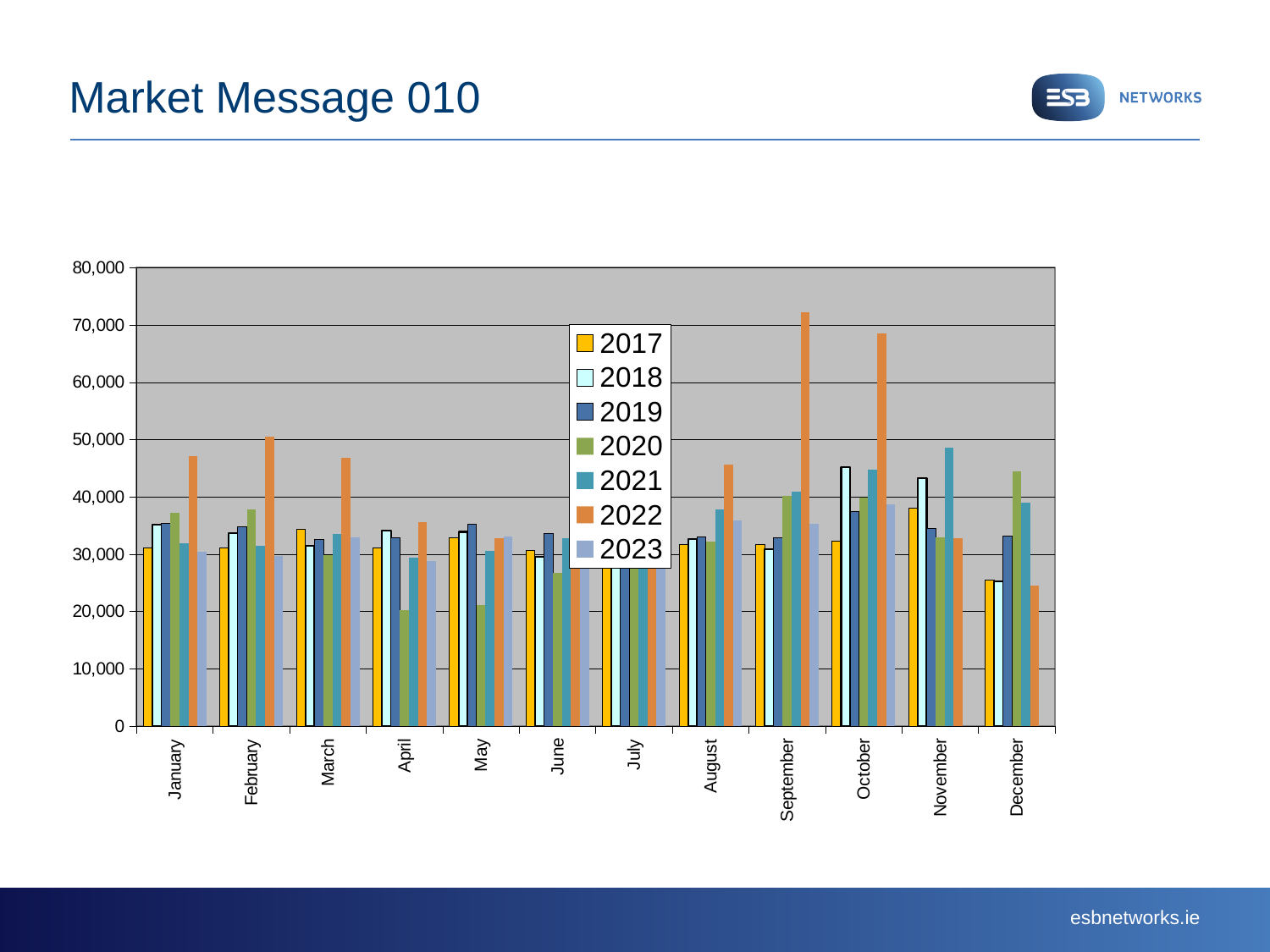
How many months are shown along the x axis? 12 Is the value for 2021 in November greater or less than 40,000? greater Which is larger: the 2022 value in September or the 2022 value in August? September Is the value for 2022 in September greater or less than 60,000? greater For the 2022 series, which month has the highest value? September In April, which year has the lowest bar? 2020 In September, which year has the highest bar? 2022 Is the value for 2022 in December greater or less than 30,000? less How many series does the legend list? 7 What kind of chart is shown on the slide? bar chart What is the first entry listed in the legend? 2017 Which is larger in November: the 2021 value or the 2022 value? 2021